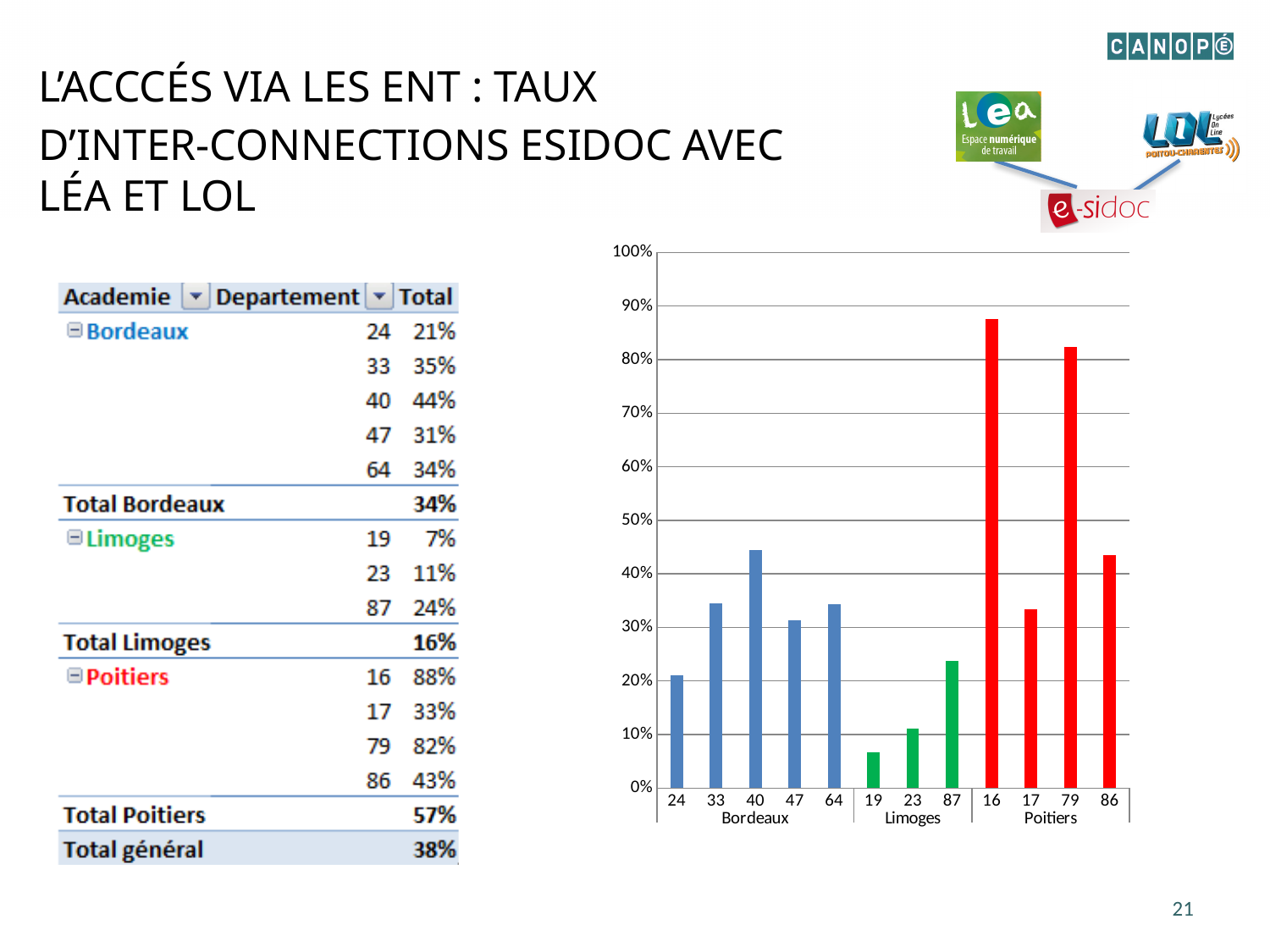
Which department has the lowest bar in the chart? 19 Is the value for department 23 greater or less than 20%? less How many academy groups are shown along the x axis of the chart? 3 What colour are the bars for the Poitiers group? red What is the value for department 40 in the Bordeaux group? 44% What is the value for department 86 in the Poitiers group? 43% Is the value for department 79 greater or less than 80%? greater Which department has the highest bar in the chart? 16 How many bars are plotted in the chart? 12 What kind of chart is shown on the slide? bar chart What is the difference between the values for department 16 and department 79? 6% Which has the larger value, department 40 or department 64? 40